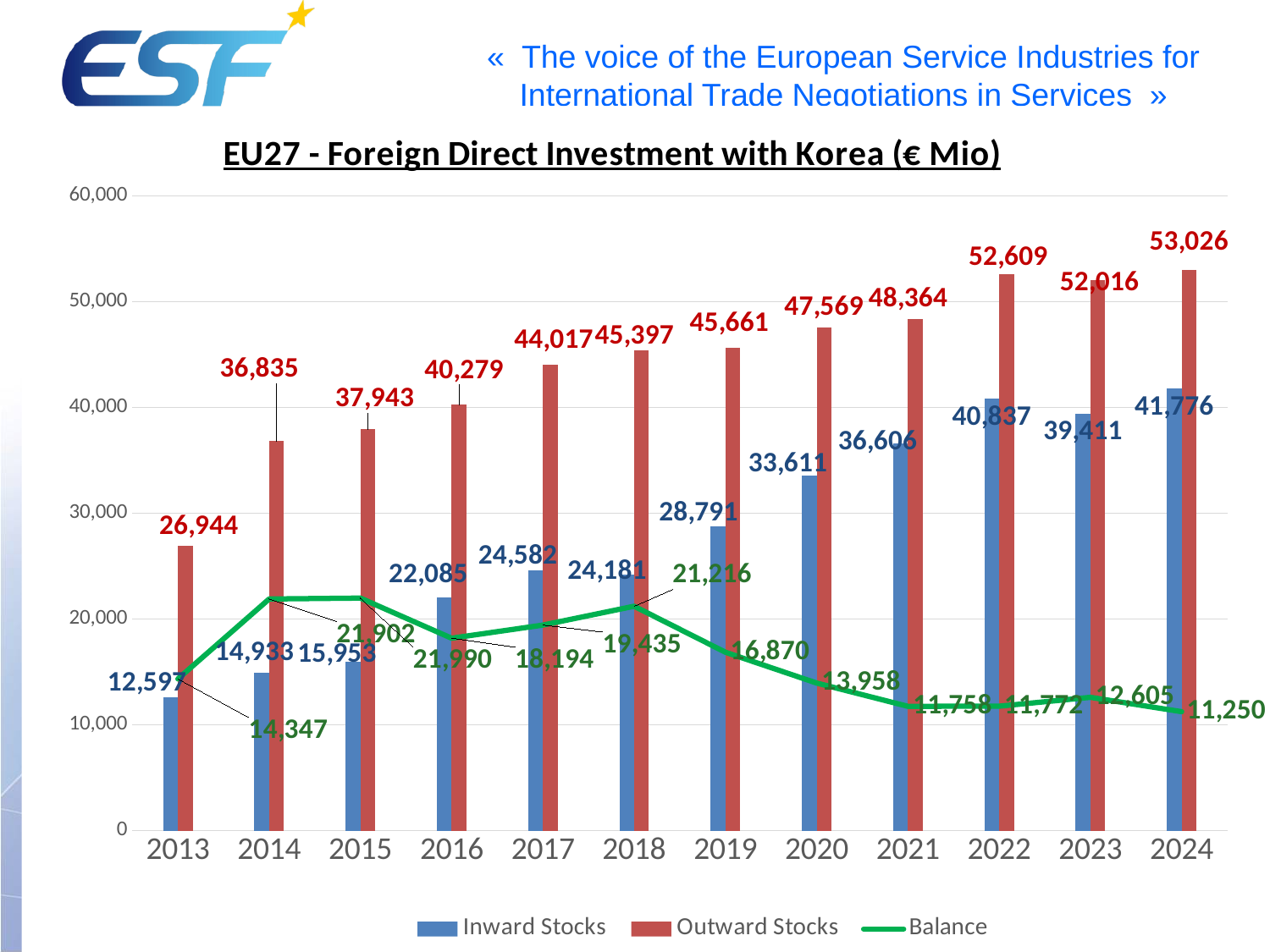
In which year is the Balance the lowest? 2024 What is the value of Inward Stocks in 2016? 22,085 How many series does the legend list? 3 Which is larger in 2023: Inward Stocks or Outward Stocks? Outward Stocks What is the value of Outward Stocks in 2024? 53,026 In which year is Outward Stocks the highest? 2024 What is the difference between Outward Stocks and Inward Stocks in 2020? 13,958 In which year is Inward Stocks the lowest? 2013 What is the Balance value for 2018? 21,216 How many years are shown on the x axis? 12 What kind of chart is used for the Inward Stocks and Outward Stocks series? Bar chart Does the Balance line generally rise or fall from 2018 to 2024? Fall